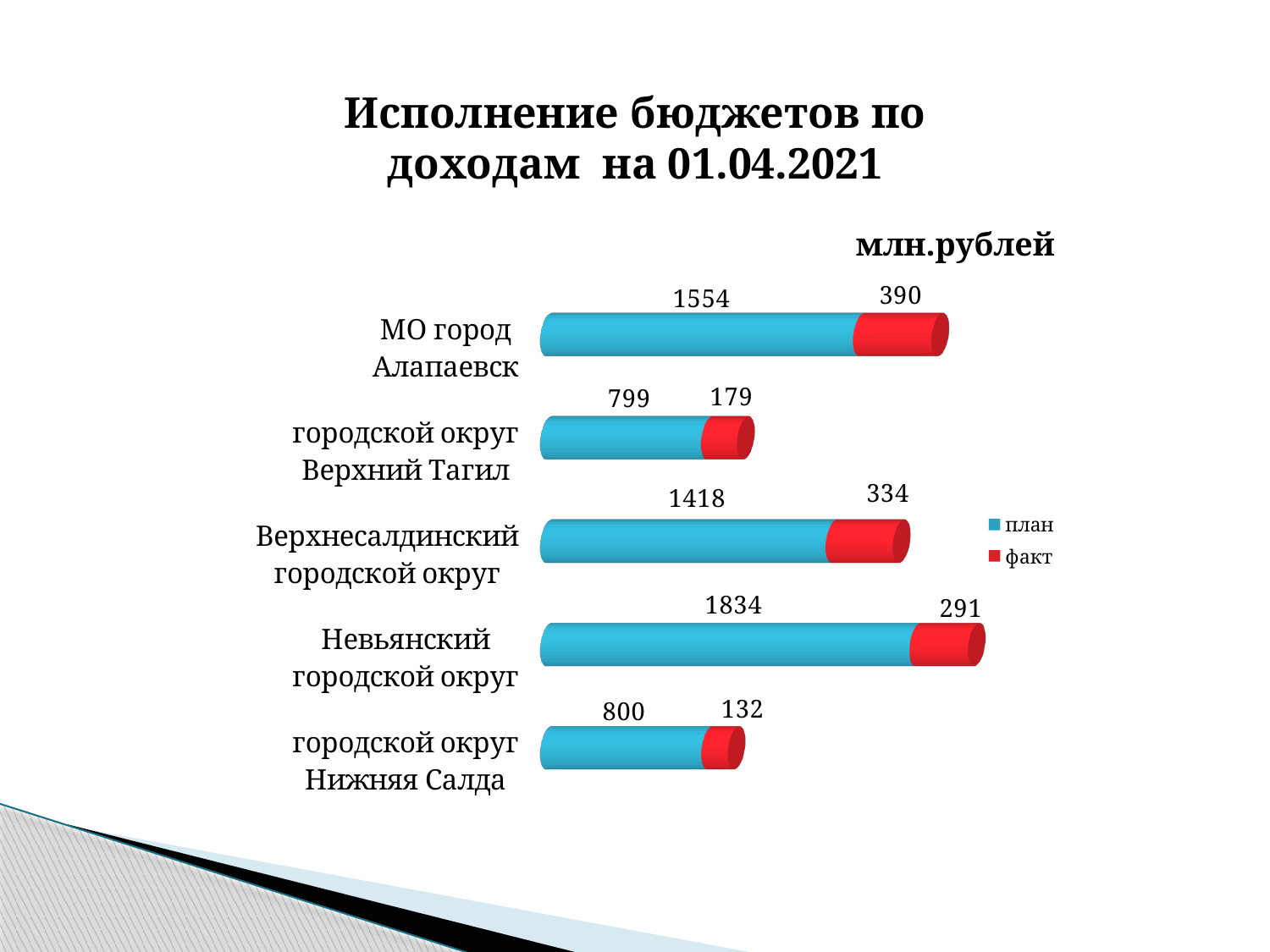
What kind of chart is shown on the slide? bar chart What is the факт value for Верхнесалдинский городской округ? 334 How many categories are shown in the chart? 5 Which is larger, the факт value for Верхнесалдинский городской округ or the факт value for Невьянский городской округ? Верхнесалдинский городской округ What is the план value for городской округ Нижняя Салда? 800 How many series does the legend list? 2 Which category has the lowest факт value? городской округ Нижняя Салда What is the факт value for МО город Алапаевск? 390 Which category has the highest план value? Невьянский городской округ What is the total of the stacked bar for МО город Алапаевск? 1944 What is the difference between the план and факт values for городской округ Верхний Тагил? 620 What is the план value for Невьянский городской округ? 1834